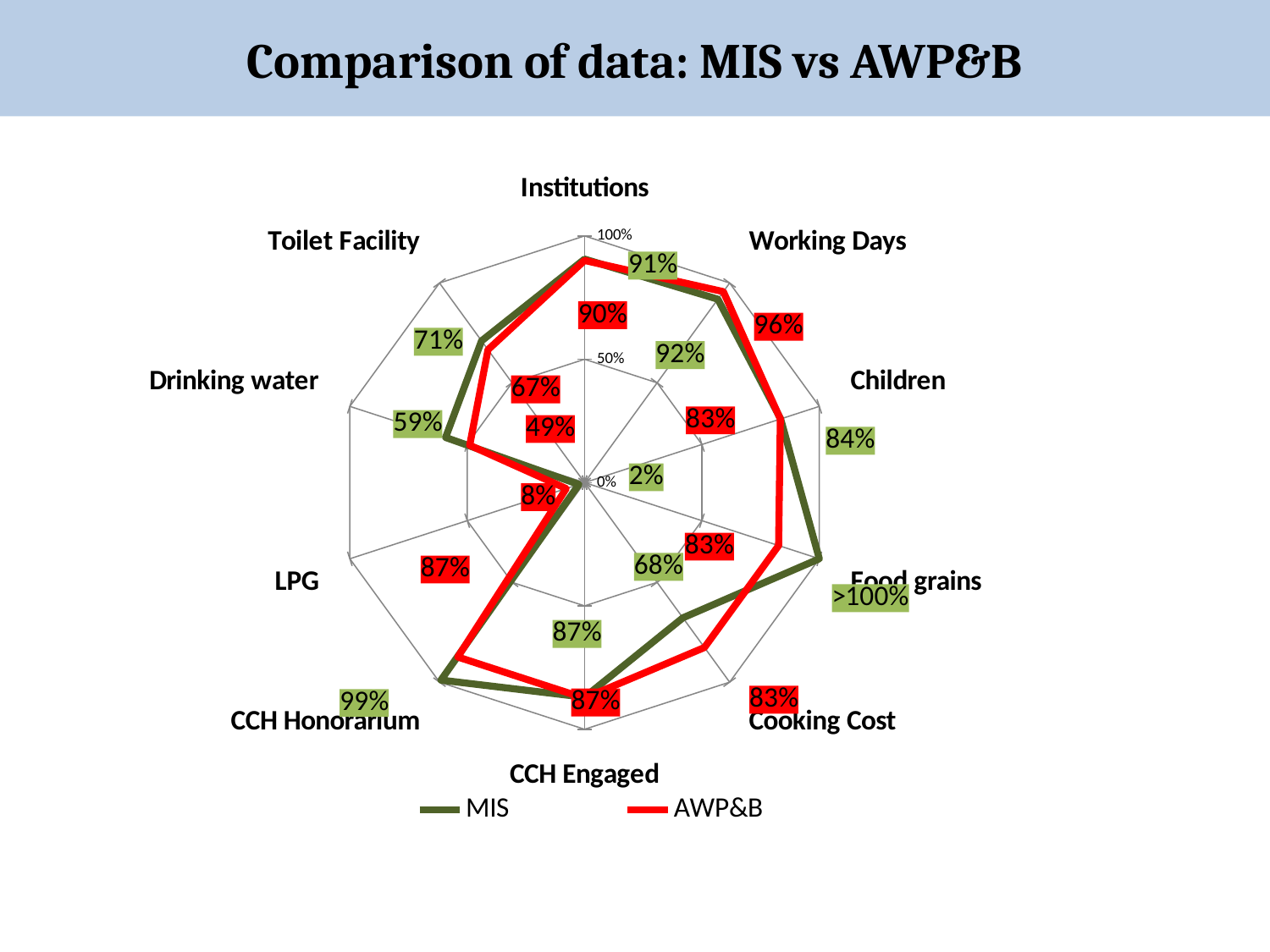
How many categories are plotted on the radar chart? 10 What is the AWP&B value for Drinking water? 49% Which is larger for Drinking water, the MIS value or the AWP&B value? MIS What is the MIS value for CCH Honorarium? 99% What is the AWP&B value for Working Days? 96% Which category has the lowest MIS value? LPG What is the MIS value for Working Days? 92% What kind of chart is shown on the slide? Radar chart What is the MIS value for Institutions? 91% Which colour represents the AWP&B series? Red How many series does the legend list? 2 What is the difference between the AWP&B and MIS values for Working Days? 4%